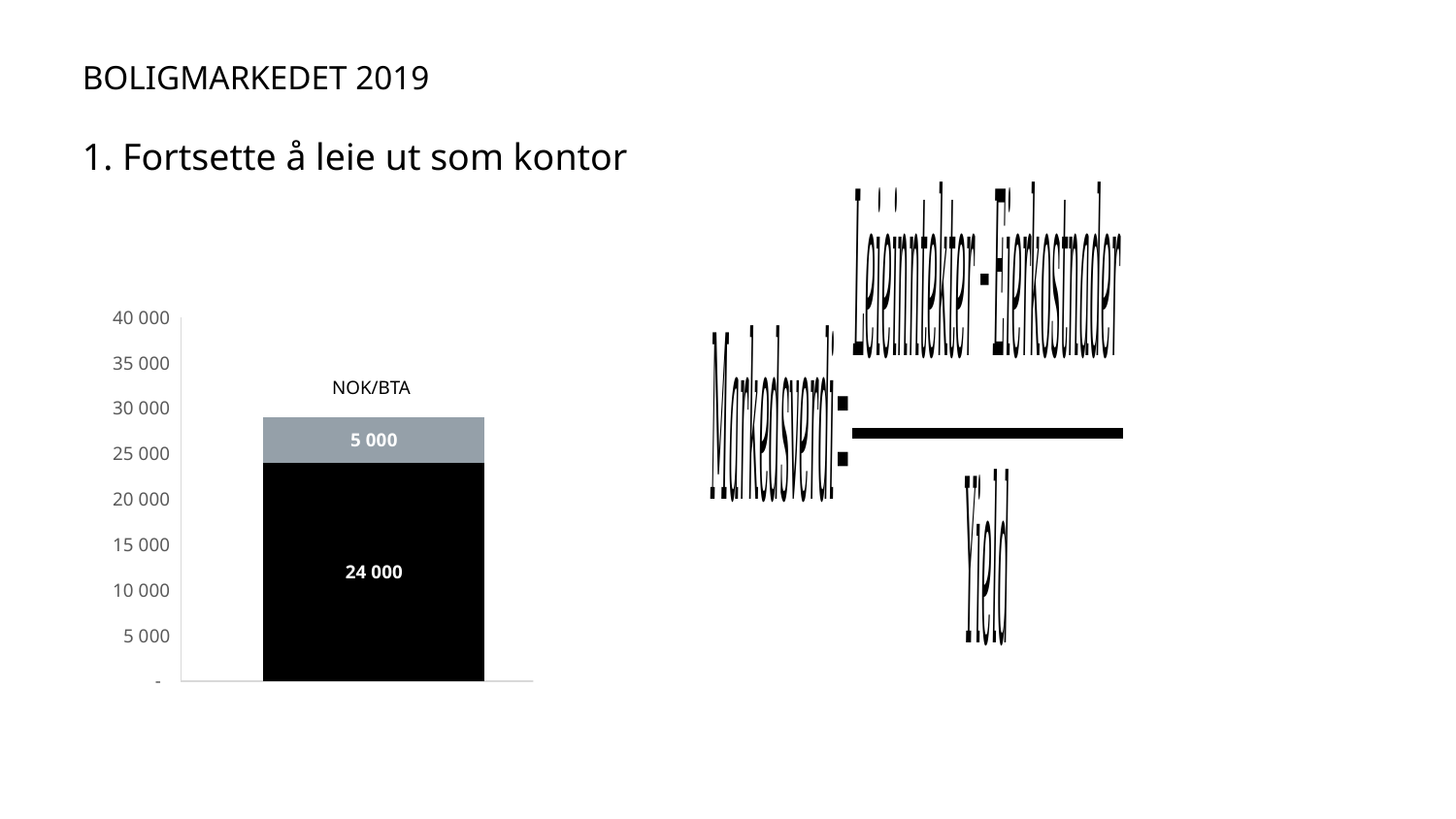
What label is printed above the bar? NOK/BTA What is the difference between the black segment and the grey segment of the bar? 19 000 What value is printed on the black segment of the bar? 24 000 How many bars does the chart contain? 1 What is the highest value shown on the vertical axis? 40 000 What kind of chart is shown on the slide? stacked bar chart Which segment of the bar is larger, the black one or the grey one? the black one Is the total height of the bar greater or less than 30 000? less What is the total of the stacked bar labelled NOK/BTA? 29 000 What value is printed on the grey segment of the bar? 5 000 Is the total height of the bar greater or less than 25 000? greater